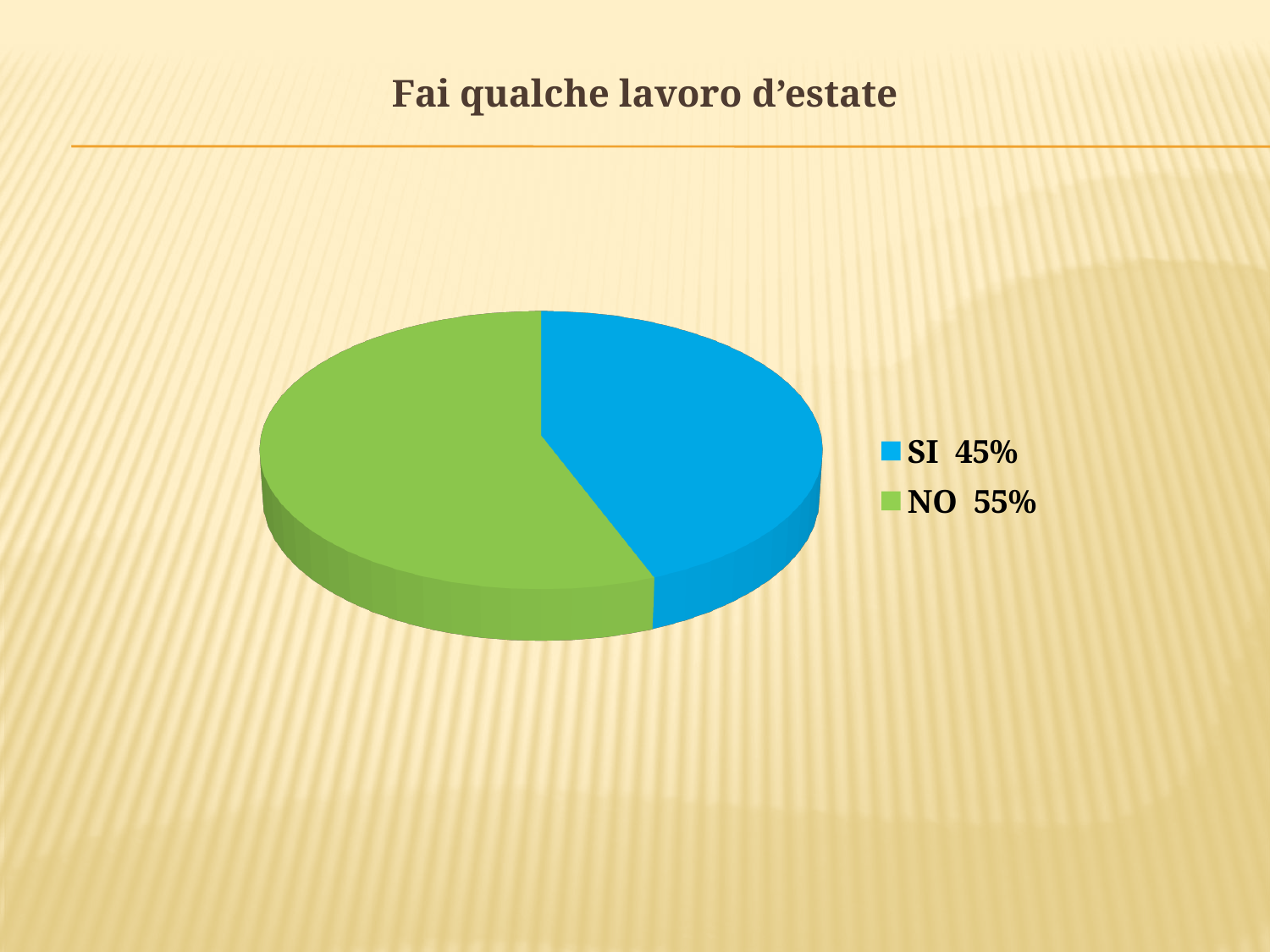
How many entries does the legend list? 2 What share of the pie does SI represent? 45% What is the difference between the NO share and the SI share? 10% What colour is the SI slice? blue What is the title of the chart? Fai qualche lavoro d'estate Which slice is the smallest? SI What is the total of the SI and NO shares? 100% What share of the pie does NO represent? 55% What kind of chart is shown on the slide? pie chart Which slice is the largest? NO Which is larger, SI or NO? NO How many slices does the pie chart have? 2